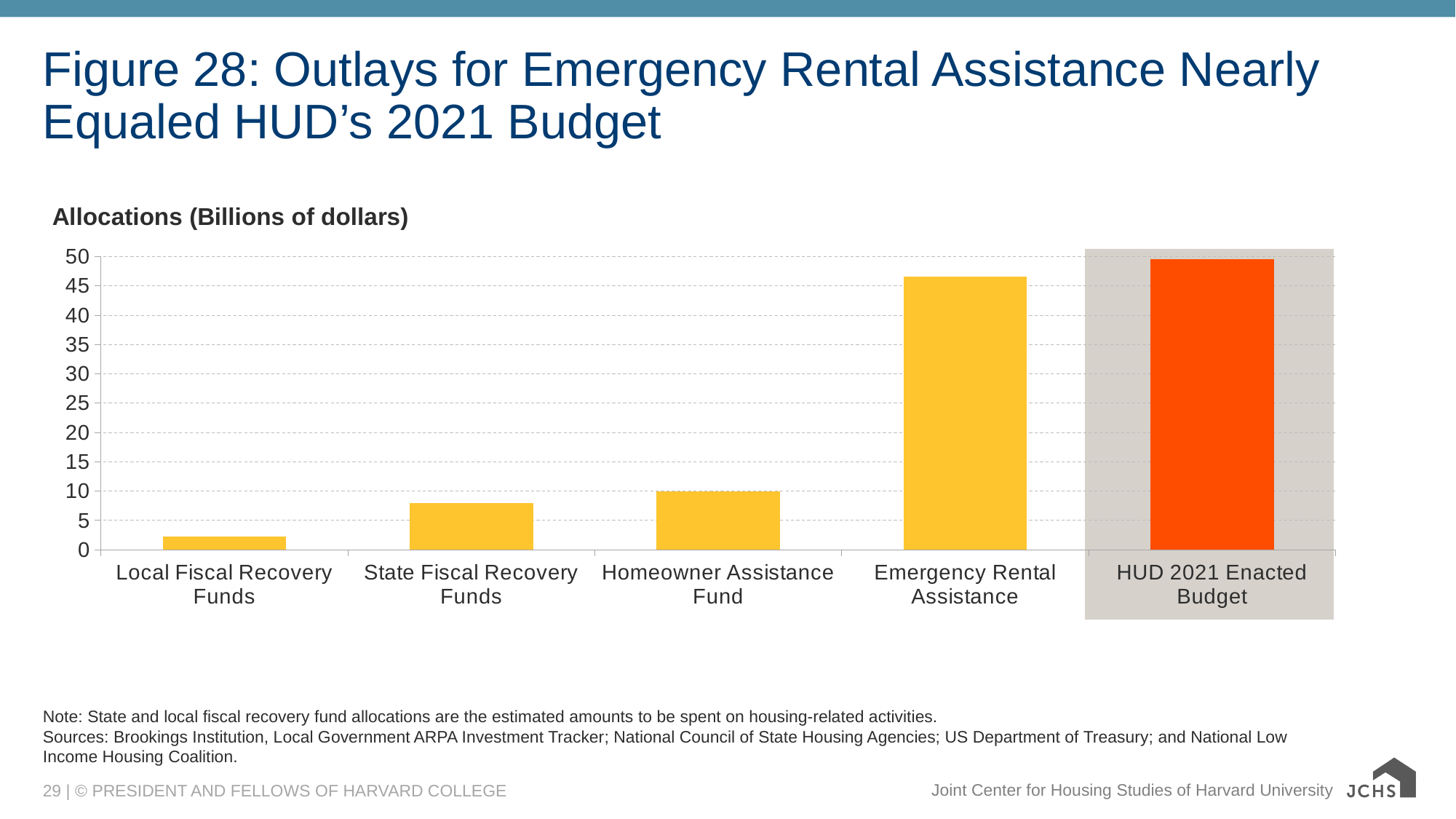
Which is larger, the value for Emergency Rental Assistance or the value for HUD 2021 Enacted Budget? HUD 2021 Enacted Budget Which category has the highest value? HUD 2021 Enacted Budget Which category's bar is shown in a different colour (orange-red) from the others? HUD 2021 Enacted Budget How many categories are plotted on the chart? 5 Is the value for State Fiscal Recovery Funds greater or less than 10? less Is the value for Local Fiscal Recovery Funds greater or less than 5? less Is the value for HUD 2021 Enacted Budget greater or less than 45? greater Which category has the lowest value? Local Fiscal Recovery Funds Which is larger, the value for State Fiscal Recovery Funds or the value for Homeowner Assistance Fund? Homeowner Assistance Fund What unit does the chart's axis label say the allocations are measured in? Billions of dollars What kind of chart is shown on the slide? Bar chart